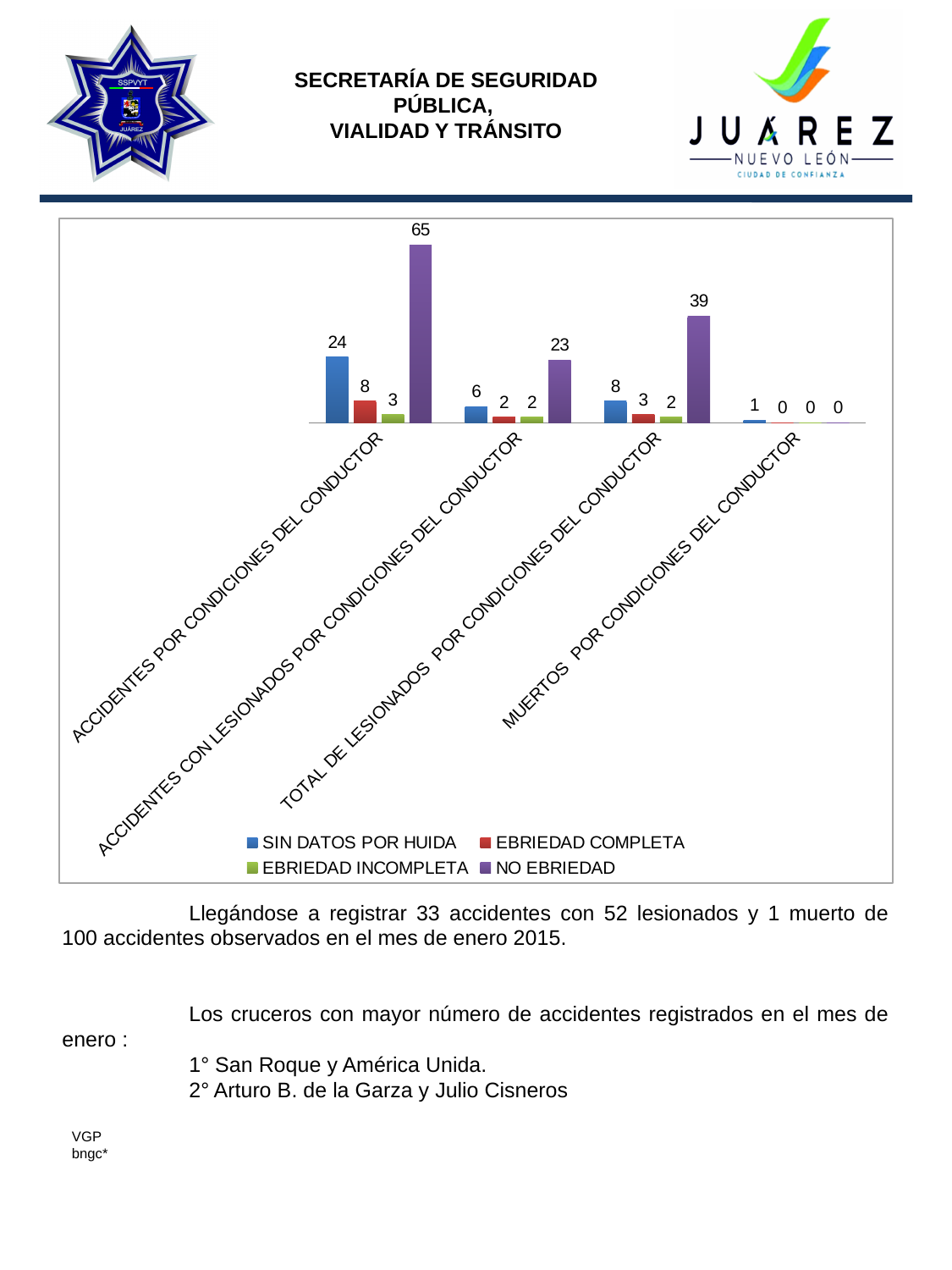
What is the value of SIN DATOS POR HUIDA for ACCIDENTES CON LESIONADOS POR CONDICIONES DEL CONDUCTOR? 6 What type of chart is shown on the slide? bar chart How many series does the legend list? 4 Which is larger for ACCIDENTES POR CONDICIONES DEL CONDUCTOR: SIN DATOS POR HUIDA or EBRIEDAD COMPLETA? SIN DATOS POR HUIDA What colour are the NO EBRIEDAD bars? purple Which category has the highest NO EBRIEDAD value? ACCIDENTES POR CONDICIONES DEL CONDUCTOR What is the value of EBRIEDAD COMPLETA for TOTAL DE LESIONADOS POR CONDICIONES DEL CONDUCTOR? 3 What is the value of NO EBRIEDAD for MUERTOS POR CONDICIONES DEL CONDUCTOR? 0 What is the value of NO EBRIEDAD for ACCIDENTES POR CONDICIONES DEL CONDUCTOR? 65 What is the difference between the NO EBRIEDAD values for ACCIDENTES POR CONDICIONES DEL CONDUCTOR and TOTAL DE LESIONADOS POR CONDICIONES DEL CONDUCTOR? 26 Which category has the lowest SIN DATOS POR HUIDA value? MUERTOS POR CONDICIONES DEL CONDUCTOR How many categories are shown on the x axis? 4